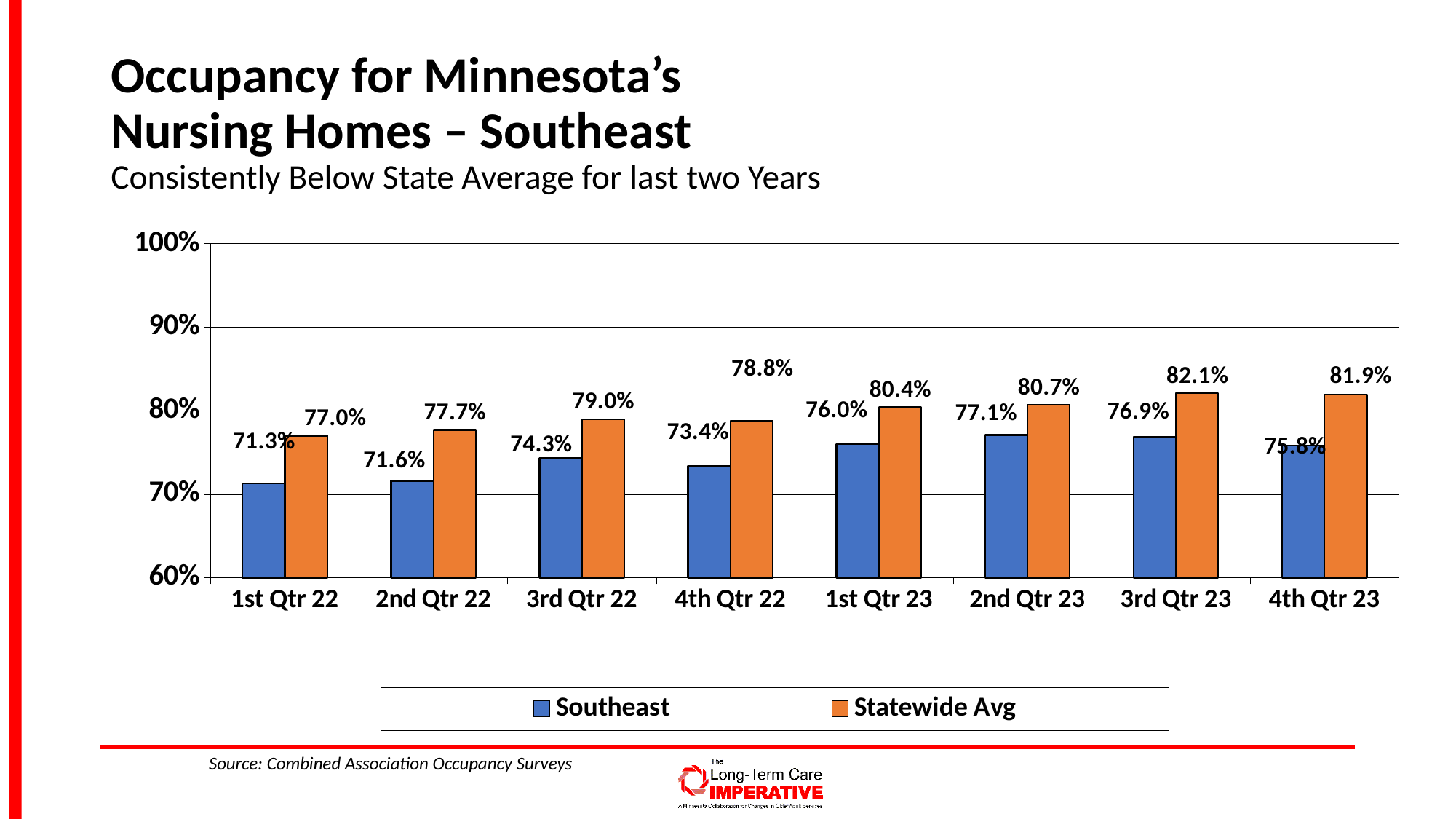
In which quarter is the Southeast occupancy highest? 2nd Qtr 23 How many quarters are shown on the x axis? 8 What is the Southeast occupancy value for 1st Qtr 22? 71.3% Is the Southeast value for 2nd Qtr 22 greater or less than 80%? less What is the Southeast occupancy value for 4th Qtr 23? 75.8% What is the Statewide Avg occupancy value for 3rd Qtr 23? 82.1% Which colour represents the Statewide Avg series? orange In which quarter is the Statewide Avg occupancy lowest? 1st Qtr 22 How many series does the legend list? 2 Which is larger in 3rd Qtr 22: the Southeast value or the Statewide Avg value? Statewide Avg What is the difference between the Statewide Avg and Southeast values in 4th Qtr 23? 6.1% What kind of chart is shown on the slide? bar chart